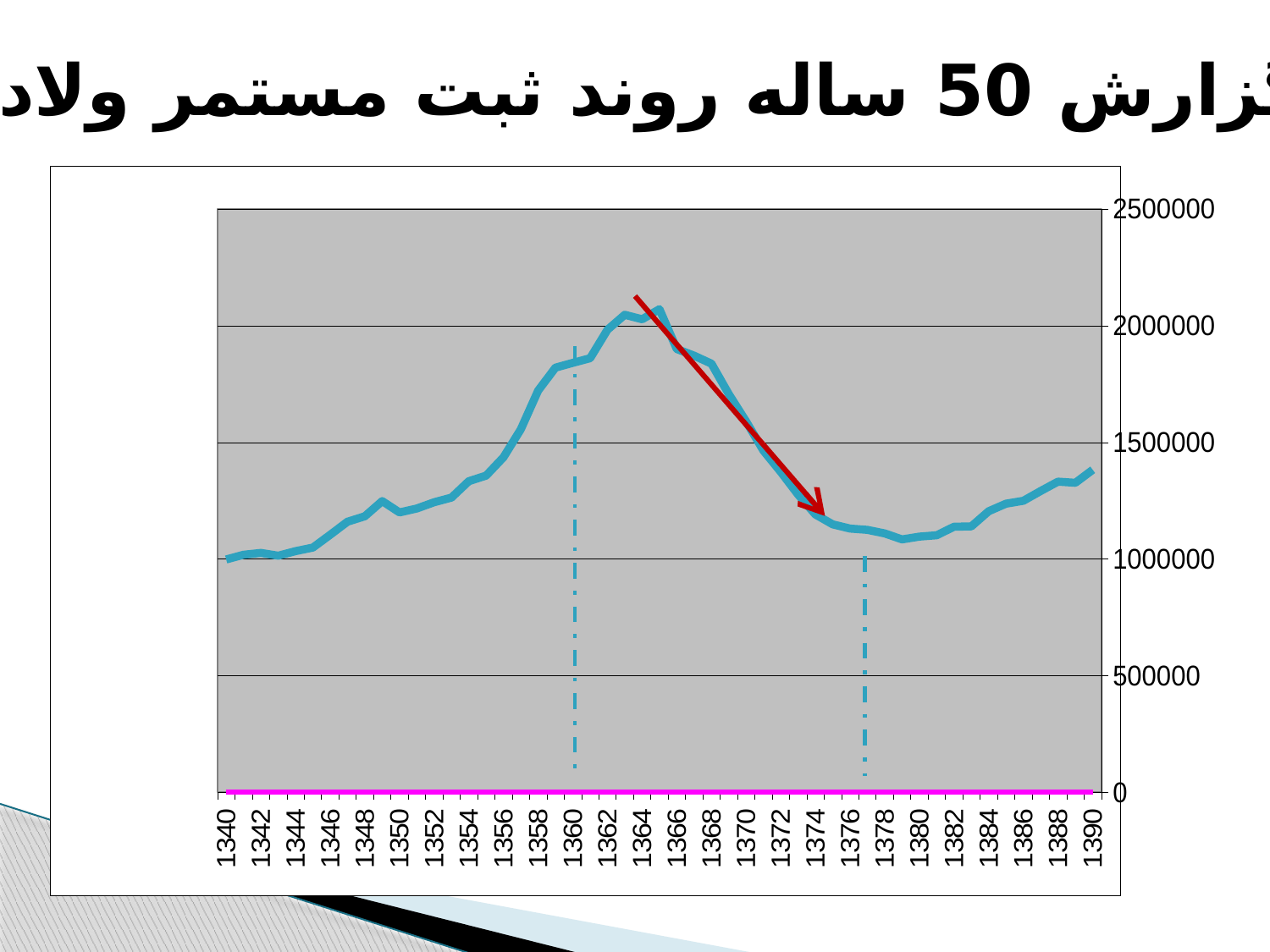
Is the value for 1390 greater or less than 1000000? greater Is the value for 1340 greater or less than 1500000? less What kind of chart is shown on the slide? line chart Which year has the larger value, 1364 or 1390? 1364 Which year has the larger value, 1340 or 1390? 1390 Do the values rise or fall between 1364 and 1378? fall Do the values rise or fall between 1340 and 1364? rise Is the value for 1378 greater or less than 1500000? less What is the highest value labelled on the vertical axis? 2500000